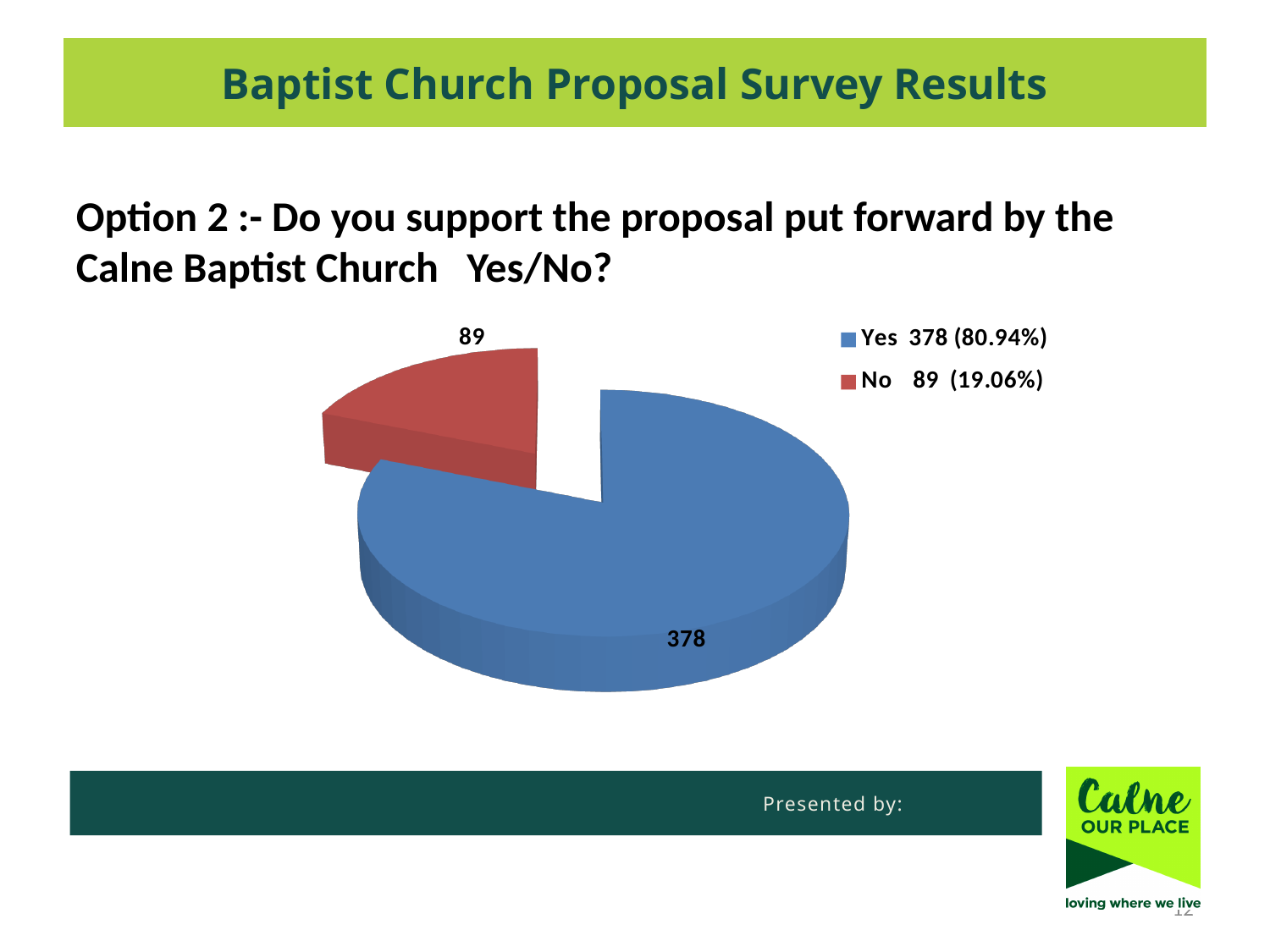
What is the difference between the number of Yes and No responses? 289 How many responses are shown for Yes? 378 Is the value for Yes larger or smaller than the value for No? Larger How many responses are shown for No? 89 What kind of chart is shown on the slide? Pie chart How many slices does the pie chart have? 2 What colour is the No slice of the pie chart? Red Which response has the larger slice of the pie? Yes What share of the pie does the Yes slice represent, as shown in the legend? 80.94% Which response has the smaller slice of the pie? No What is the total number of responses shown in the pie chart? 467 What share of the pie does the No slice represent, as shown in the legend? 19.06%